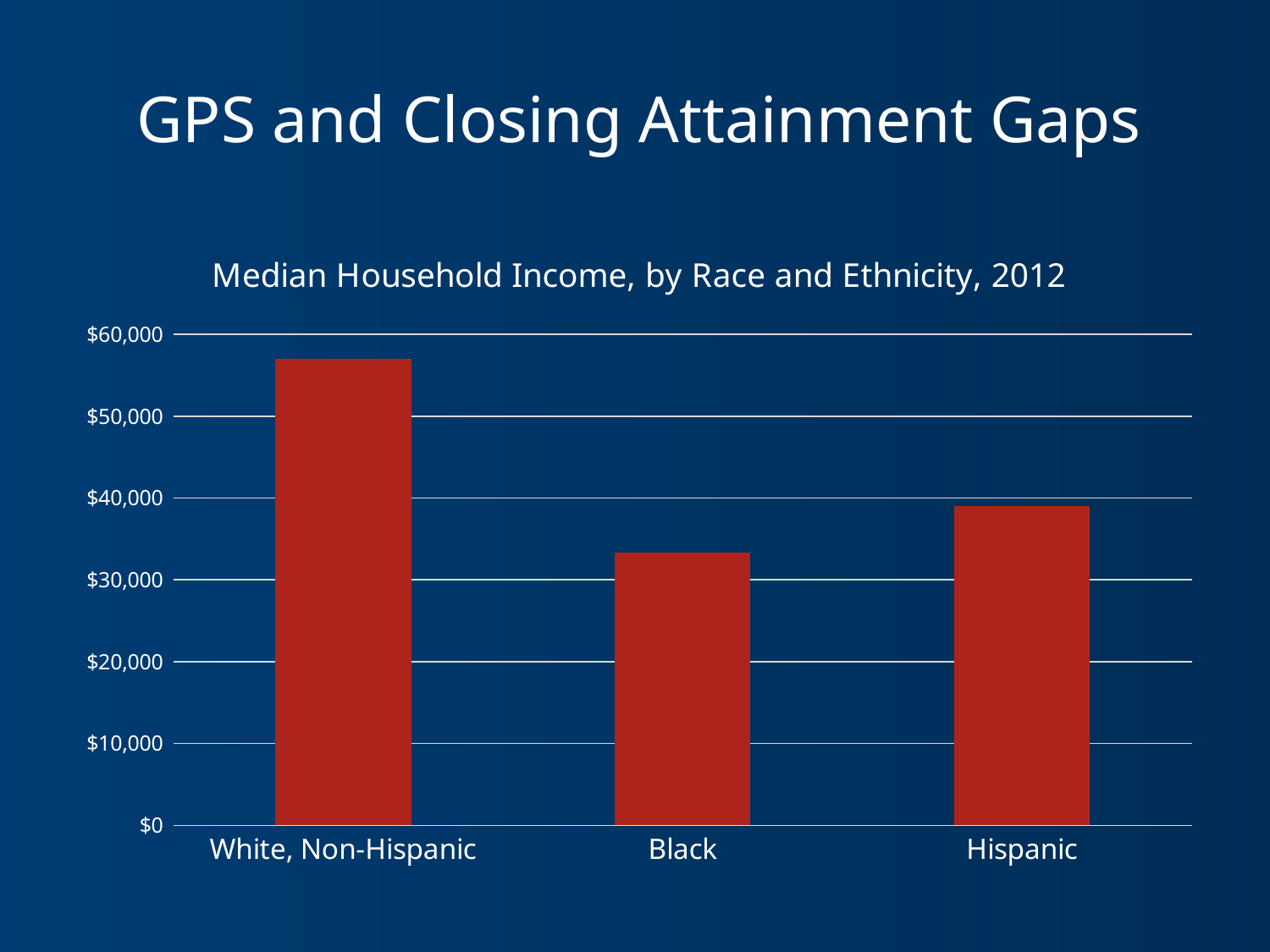
What is the title of the chart? Median Household Income, by Race and Ethnicity, 2012 Is the value for Black greater or less than $40,000? less Which is larger, the value for Black or the value for Hispanic? Hispanic Is the value for White, Non-Hispanic greater or less than $60,000? less How many categories are shown on the x axis? 3 Is the value for White, Non-Hispanic greater or less than $50,000? greater Which category has the lowest median household income? Black What kind of chart is shown on the slide? bar chart What colour are the bars in the chart? red Which category has the highest median household income? White, Non-Hispanic